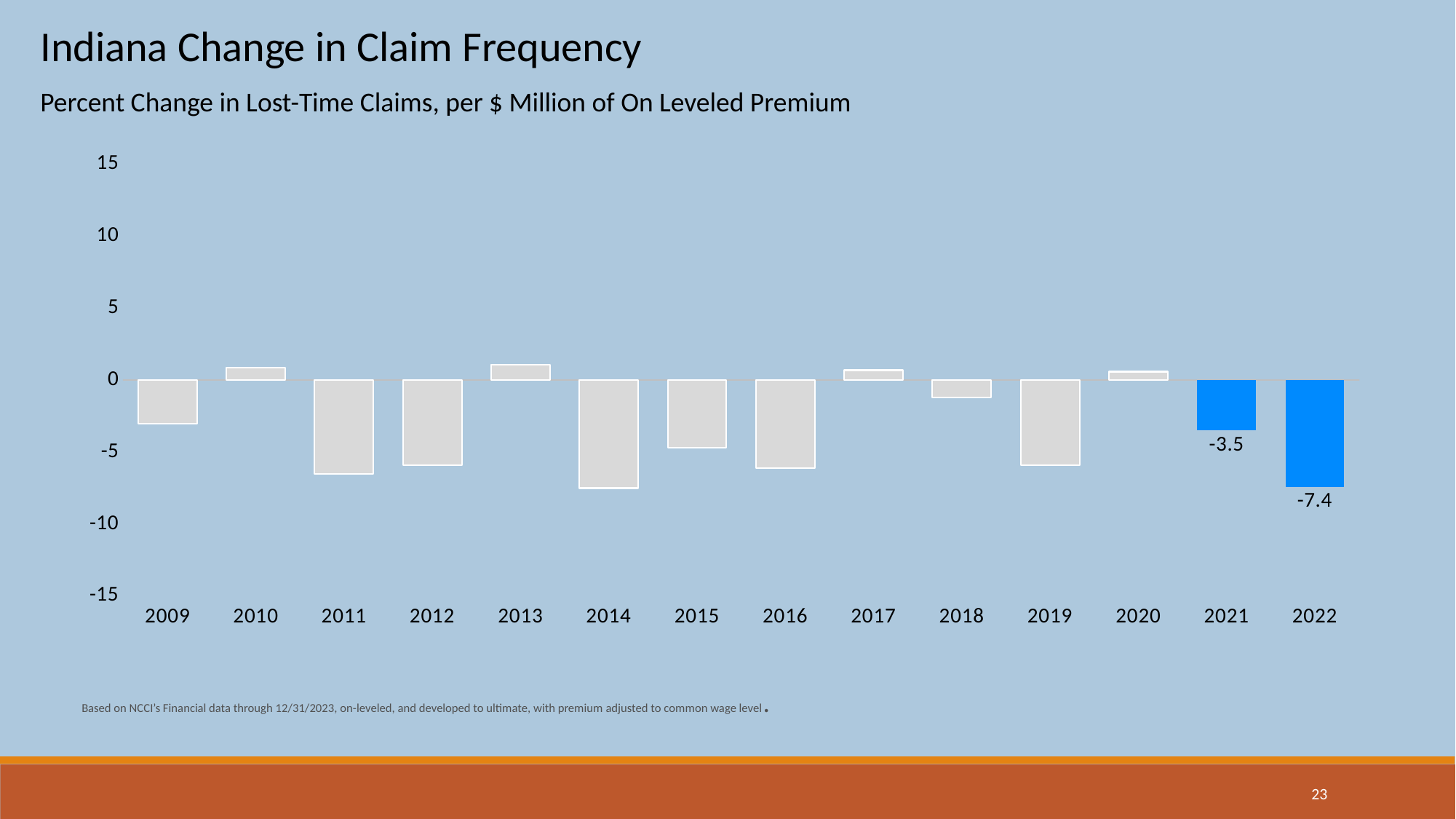
Which year has the larger value, 2021 or 2022? 2021 Is the value for 2011 greater or less than -5? less What is the difference between the values for 2021 and 2022? 3.9 How many years are shown on the x axis? 14 Which years are shown with blue bars? 2021 and 2022 Is the value for 2014 greater or less than -5? less What is the value for 2022? -7.4 What kind of chart is shown on the slide? Bar chart Is the value for 2018 greater or less than -5? greater What is the value for 2021? -3.5